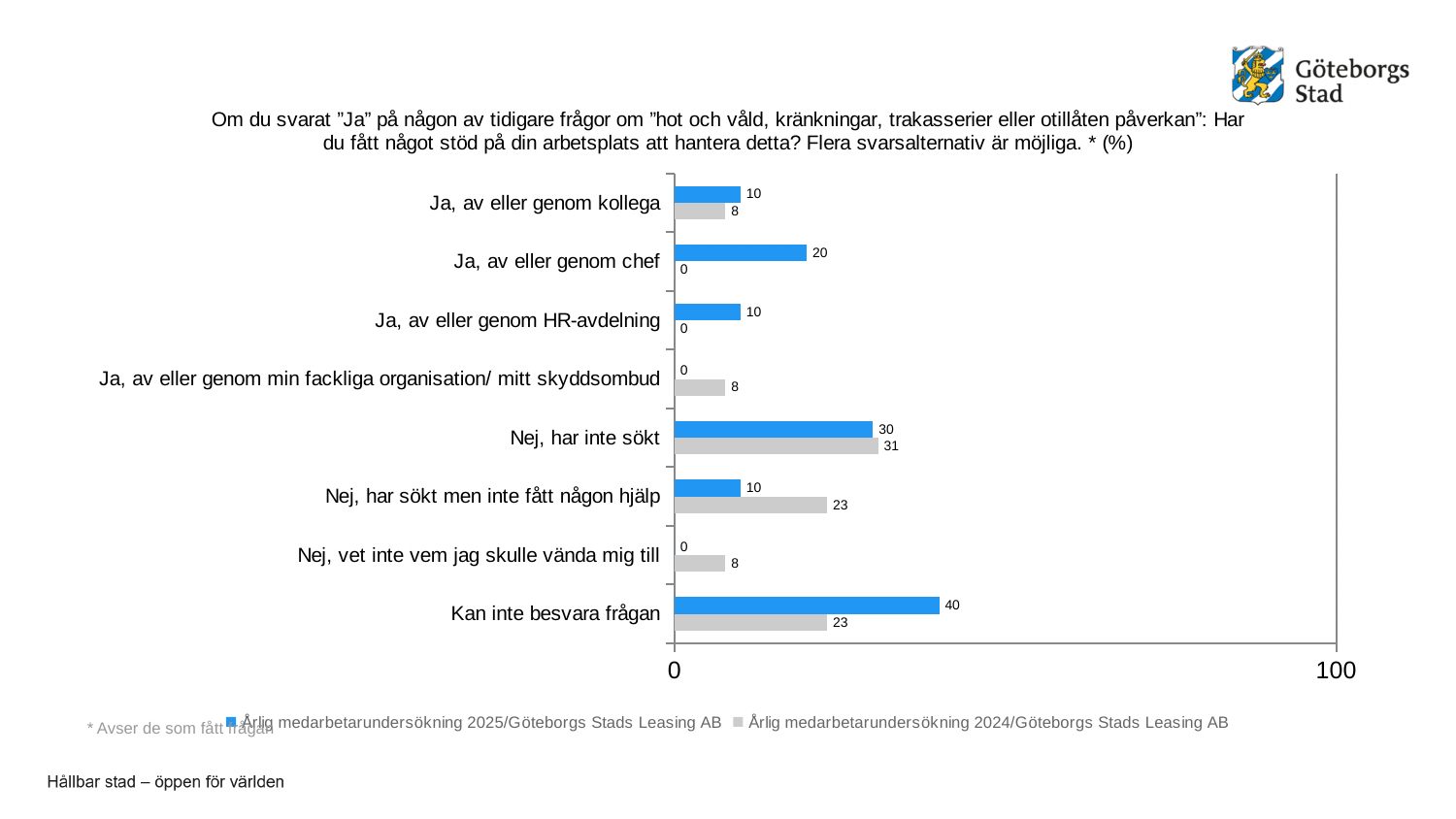
What is the difference between the 2024 and 2025 values for "Nej, har sökt men inte fått någon hjälp"? 13 What is the difference between the 2025 and 2024 values for "Kan inte besvara frågan"? 17 For "Nej, vet inte vem jag skulle vända mig till", which series has the larger value, 2025 or 2024? 2024 How many series does the legend list? 2 For "Ja, av eller genom kollega", which series has the larger value, 2025 or 2024? 2025 What kind of chart is shown on the slide? Bar chart What is the value for "Ja, av eller genom chef" in the Årlig medarbetarundersökning 2025 series? 20 What is the value for "Nej, har sökt men inte fått någon hjälp" in the Årlig medarbetarundersökning 2024 series? 23 What is the value for "Nej, har inte sökt" in the Årlig medarbetarundersökning 2024 series? 31 How many categories are shown on the chart? 8 Which category has the highest value in the Årlig medarbetarundersökning 2024 series? Nej, har inte sökt Which category has the highest value in the Årlig medarbetarundersökning 2025 series? Kan inte besvara frågan